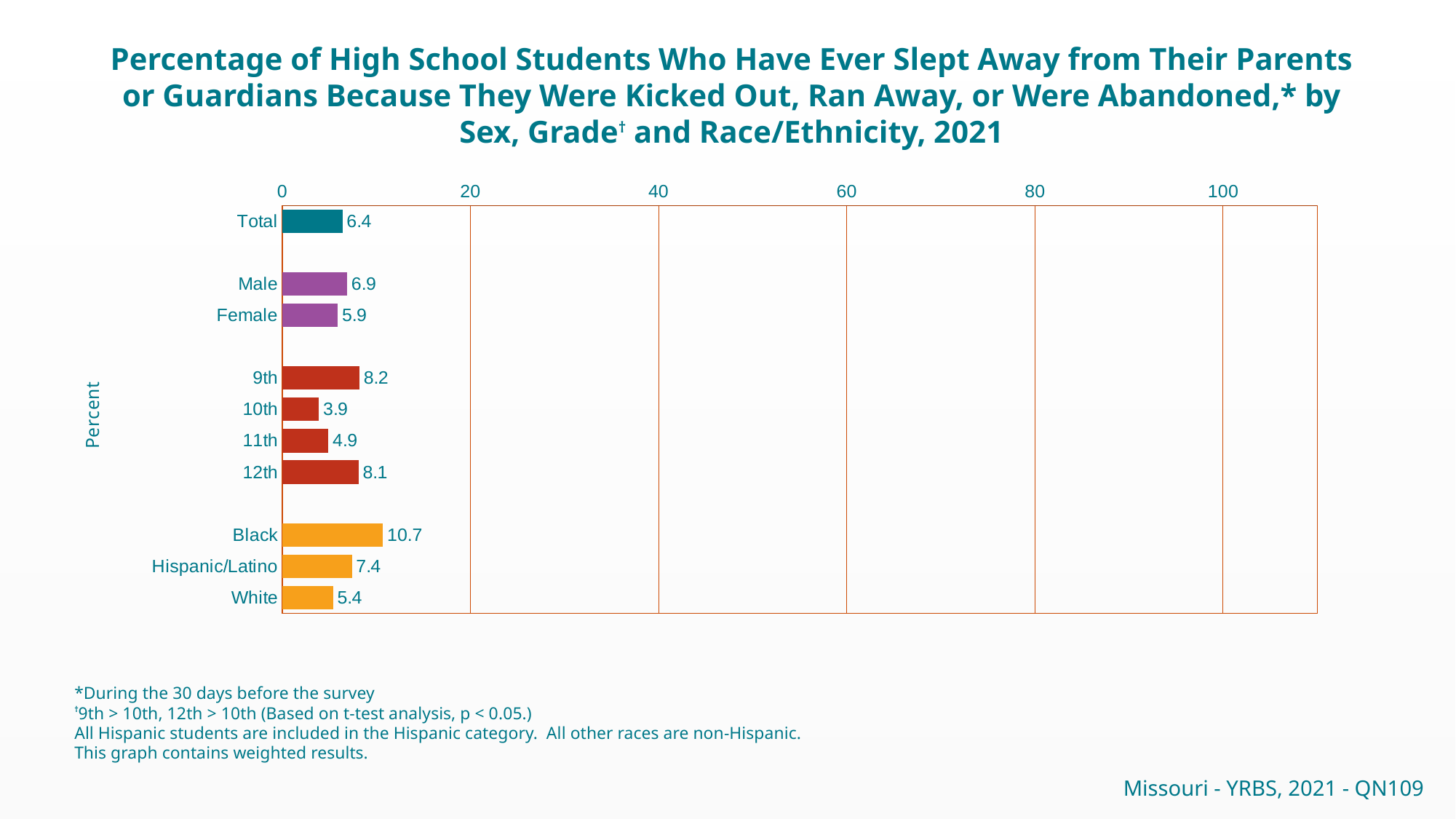
What is the value for 10th grade? 3.9 What is the value for Black students? 10.7 Which category has the lowest value? 10th How many categories are plotted in the chart? 10 What kind of chart is shown? bar chart What is the difference between the Black and White values? 5.3 What is the label on the vertical axis? Percent What is the difference between the Male and Female values? 1.0 Which is larger, the value for 9th grade or 11th grade? 9th Which category has the highest value? Black What is the value for Total? 6.4 Is the value for Hispanic/Latino greater or less than 20? less